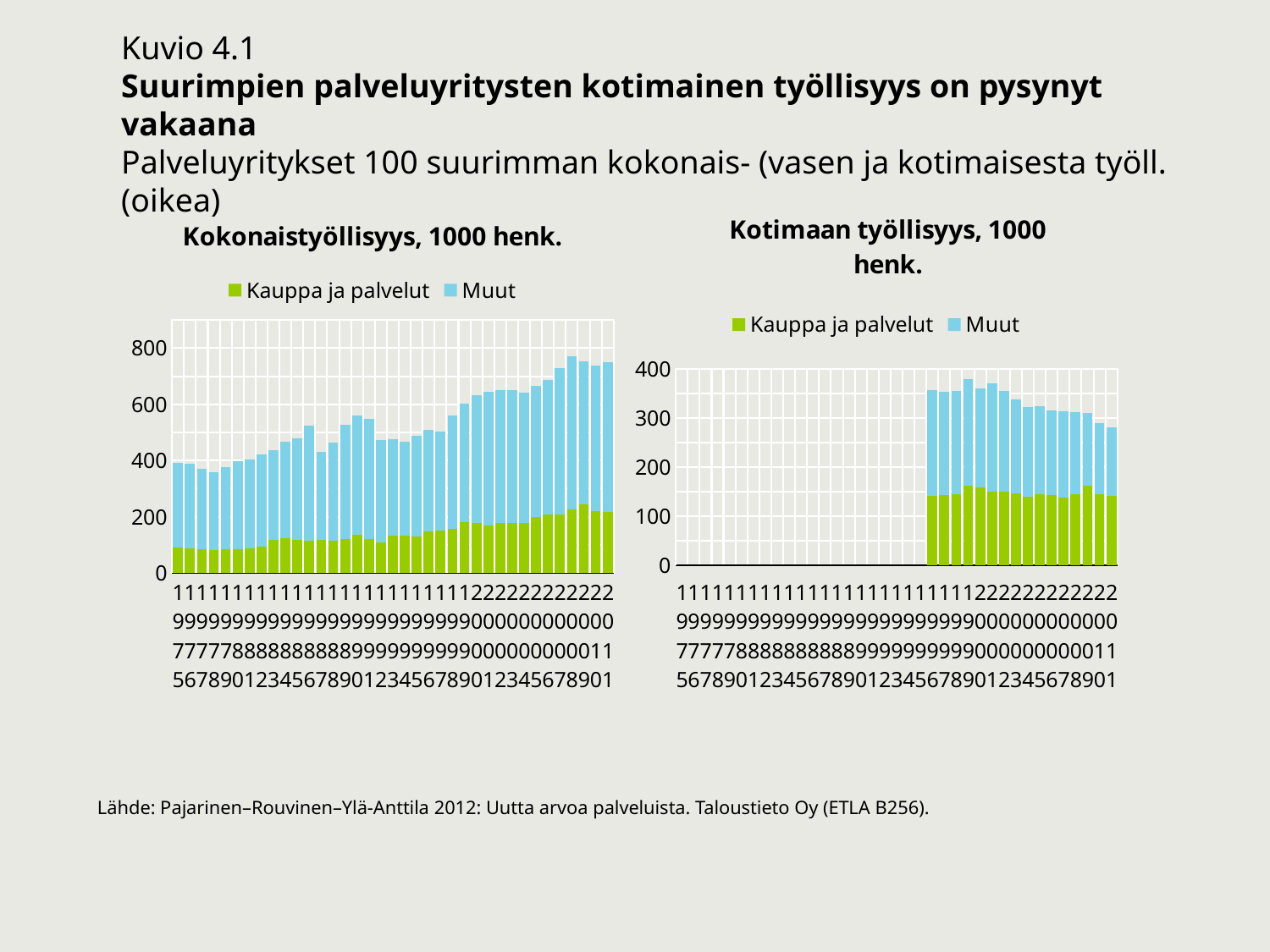
In the right chart, 'Kotimaan työllisyys, 1000 henk.', is the Kauppa ja palvelut value for 2005 greater or less than 100? greater In the left chart, 'Kokonaistyöllisyys, 1000 henk.', is the total bar for 2009 greater or less than 600? greater In the left chart, 'Kokonaistyöllisyys, 1000 henk.', is the total bar for 1976 greater or less than 600? less In the right chart, 'Kotimaan työllisyys, 1000 henk.', which total bar is larger: 2002 or 2011? 2002 In the left chart, 'Kokonaistyöllisyys, 1000 henk.', which series is shown in green? Kauppa ja palvelut In the left chart, 'Kokonaistyöllisyys, 1000 henk.', do the total bars generally rise or fall from 1975 to 2009? Rise How many series does the legend of the right chart, 'Kotimaan työllisyys, 1000 henk.', list? 2 What is the title of the right chart? Kotimaan työllisyys, 1000 henk. In the left chart, 'Kokonaistyöllisyys, 1000 henk.', which total bar is larger: 1975 or 2009? 2009 What kind of chart is the left chart, 'Kokonaistyöllisyys, 1000 henk.'? Stacked bar chart